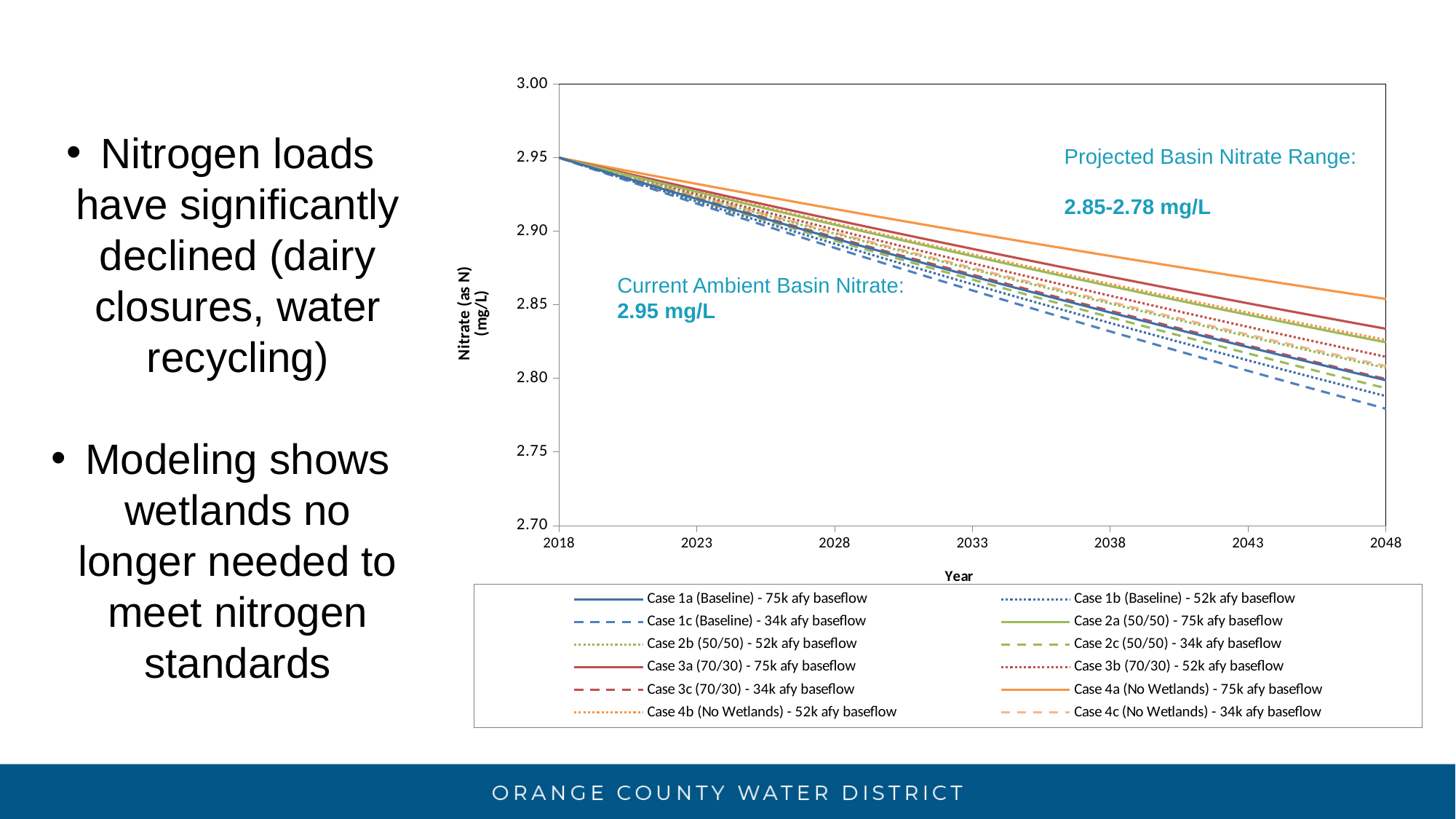
How many series does the legend list? 12 What is the label of the y axis? Nitrate (as N) (mg/L) What kind of chart is shown on the slide? line chart In 2048, is the value for Case 1c (Baseline) - 34k afy baseflow greater or less than 2.80? less In 2048, is the value for Case 4a (No Wetlands) - 75k afy baseflow greater or less than 2.80? greater Which series has the lowest nitrate value in 2048? Case 1c (Baseline) - 34k afy baseflow What is the current ambient basin nitrate value shown at the start of the chart in 2018? 2.95 mg/L In 2048, which is larger: the value for Case 4a (No Wetlands) - 75k afy baseflow or Case 1a (Baseline) - 75k afy baseflow? Case 4a (No Wetlands) - 75k afy baseflow What is the last year shown on the x axis? 2048 Do the nitrate values rise or fall from 2018 to 2048? fall Which series has the highest nitrate value in 2048? Case 4a (No Wetlands) - 75k afy baseflow What projected basin nitrate range is annotated on the chart? 2.85-2.78 mg/L